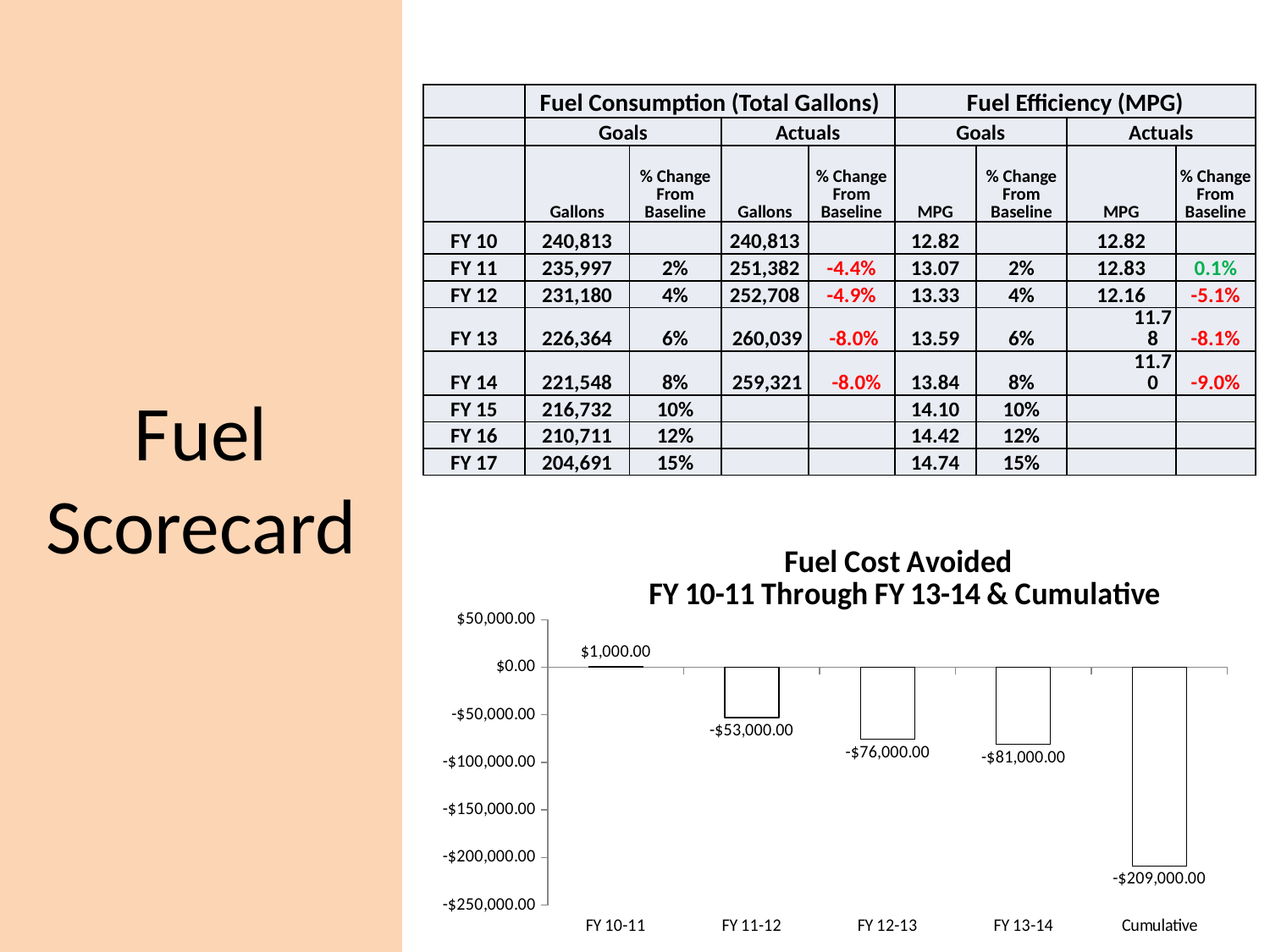
Which category has the highest value in the Fuel Cost Avoided chart? FY 10-11 What is the value for FY 13-14 in the Fuel Cost Avoided chart? -$81,000.00 Do the values in the Fuel Cost Avoided chart rise or fall from FY 10-11 to FY 13-14? fall What is the value for the Cumulative bar in the Fuel Cost Avoided chart? -$209,000.00 What is the difference between the FY 12-13 and FY 11-12 values in the Fuel Cost Avoided chart? $23,000.00 What kind of chart is the Fuel Cost Avoided chart? bar chart What is the value for FY 11-12 in the Fuel Cost Avoided chart? -$53,000.00 In the Fuel Cost Avoided chart, which is larger, the value for FY 12-13 or FY 13-14? FY 12-13 How many categories are shown on the x axis of the Fuel Cost Avoided chart? 5 Is the value for FY 13-14 in the Fuel Cost Avoided chart greater or less than -$100,000.00? greater What is the value for FY 10-11 in the Fuel Cost Avoided chart? $1,000.00 Which category has the lowest value in the Fuel Cost Avoided chart? Cumulative